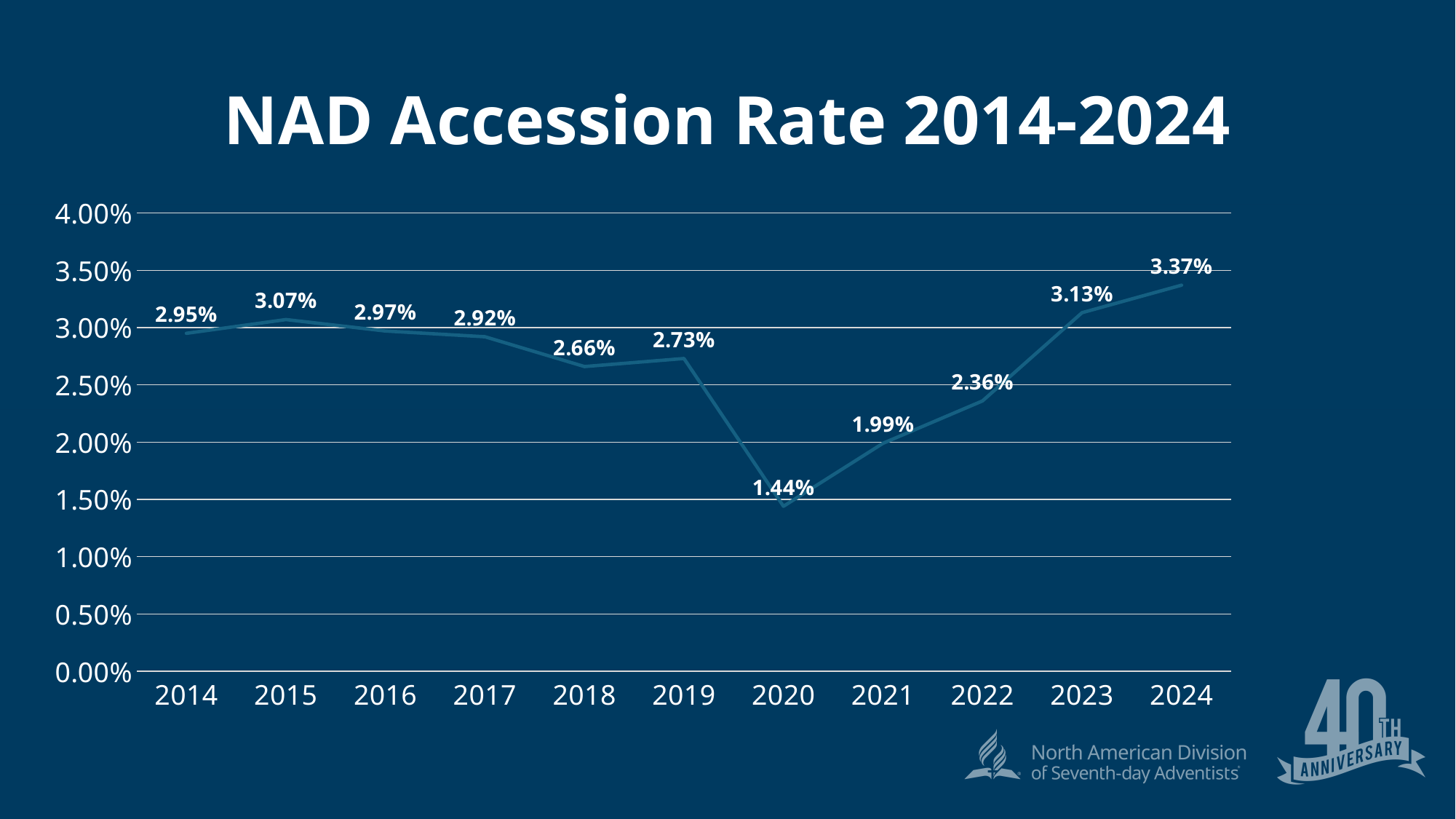
Which year has the highest accession rate? 2024 What is the NAD accession rate for 2024? 3.37% Which year has a higher accession rate, 2018 or 2019? 2019 What kind of chart is shown on the slide? line chart What is the difference between the accession rate in 2024 and in 2020? 1.93% Is the accession rate for 2021 greater or less than 2.00%? less How many years are plotted on the chart? 11 What is the NAD accession rate for 2020? 1.44% What is the title of the chart? NAD Accession Rate 2014-2024 Does the accession rate rise or fall from 2020 to 2024? rise What is the NAD accession rate for 2015? 3.07% Which year has the lowest accession rate? 2020